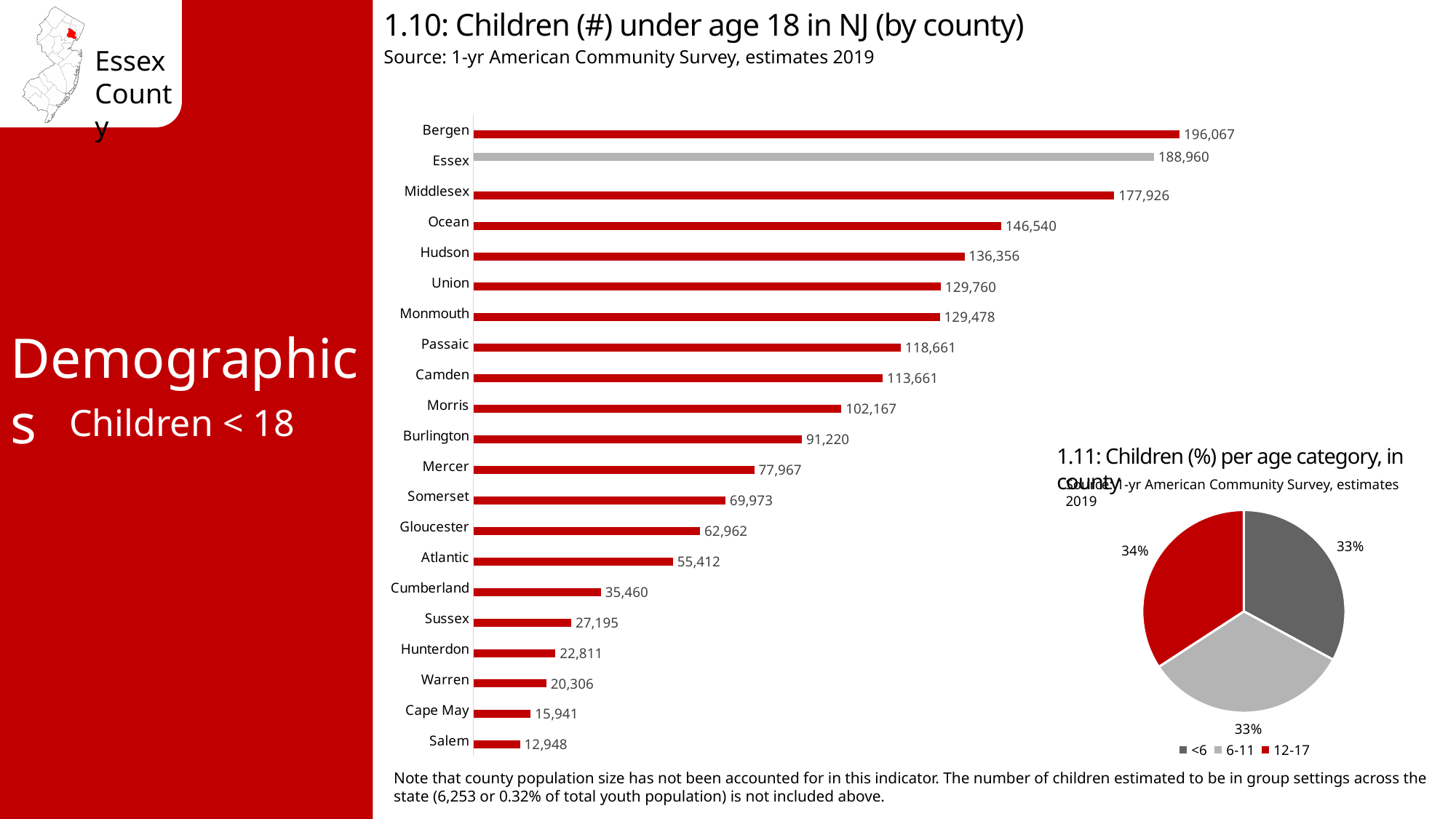
In the chart '1.10: Children (#) under age 18 in NJ (by county)', which county has the lowest number of children under 18? Salem In the chart '1.10: Children (#) under age 18 in NJ (by county)', which county's bar is coloured grey instead of red? Essex In the chart '1.10: Children (#) under age 18 in NJ (by county)', which has more children under 18, Hudson or Union? Hudson In the pie chart '1.11: Children (%) per age category, in county', which age category has the largest share? 12-17 In the pie chart '1.11: Children (%) per age category, in county', what share of children are aged 12-17? 34% In the chart '1.10: Children (#) under age 18 in NJ (by county)', which county has the highest number of children under 18? Bergen In the chart '1.10: Children (#) under age 18 in NJ (by county)', how many children under 18 are in Essex County? 188,960 What type of chart is '1.10: Children (#) under age 18 in NJ (by county)'? Bar chart In the chart '1.10: Children (#) under age 18 in NJ (by county)', what is the value for Ocean? 146,540 In the chart '1.10: Children (#) under age 18 in NJ (by county)', how many counties are shown? 21 In the chart '1.10: Children (#) under age 18 in NJ (by county)', what is the difference between Bergen and Essex? 7,107 How many categories does the legend of the pie chart '1.11: Children (%) per age category, in county' list? 3